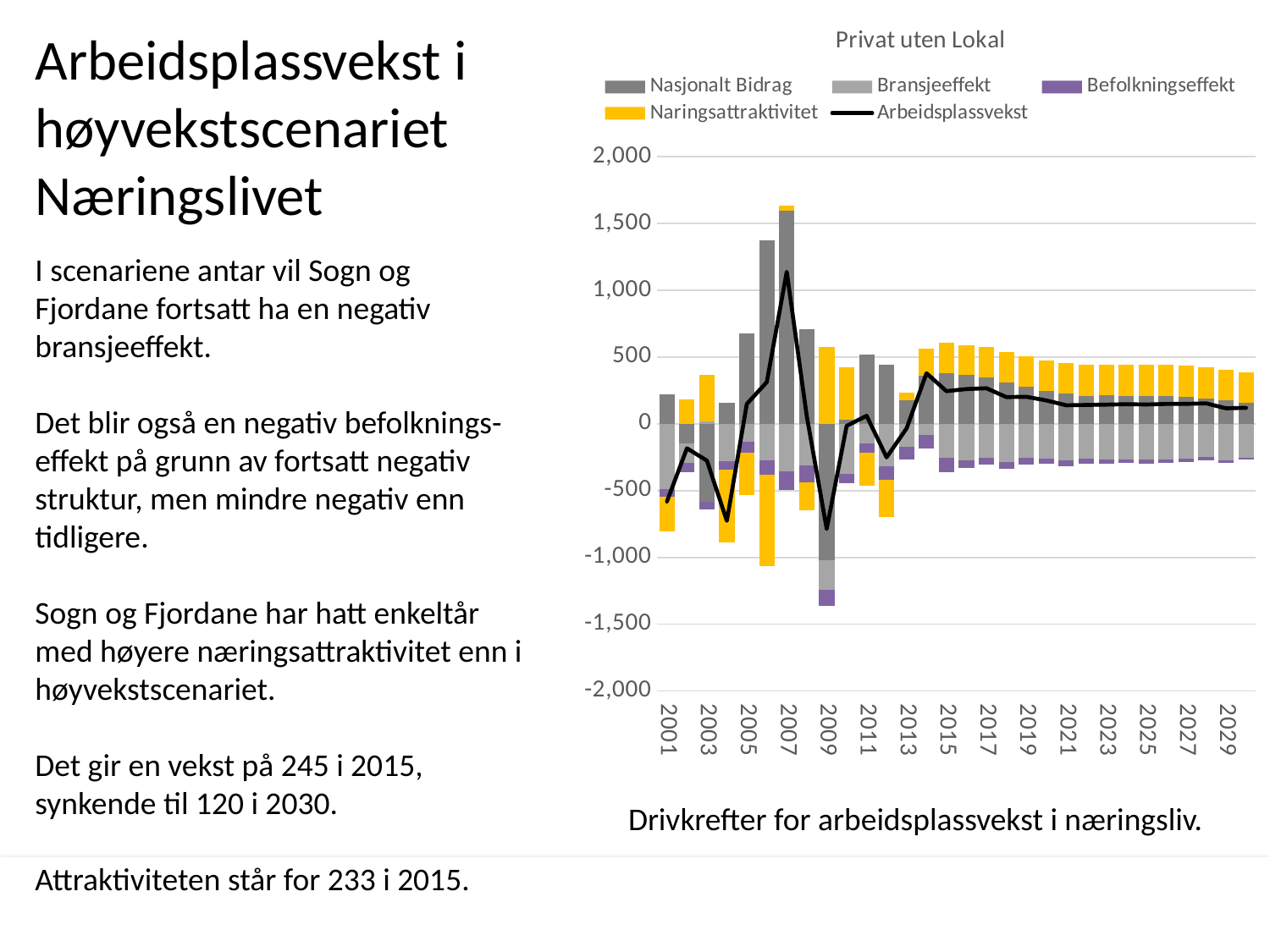
Is the Nasjonalt Bidrag value for 2007 greater or less than 1,500? greater Which year has the larger Arbeidsplassvekst value, 2006 or 2007? 2007 Is the Arbeidsplassvekst value for 2009 greater or less than -500? less Is the Arbeidsplassvekst value for 2007 greater or less than 1,000? greater Which colour represents Naringsattraktivitet in the chart? Yellow What is the title of the chart? Privat uten Lokal How many series does the chart legend list? 5 What is the first year shown on the x axis of the chart? 2001 Does the Arbeidsplassvekst line rise or fall from 2015 to 2030? fall In which year does the Arbeidsplassvekst line reach its highest value? 2007 What kind of chart is shown on the slide? A stacked bar chart combined with a line